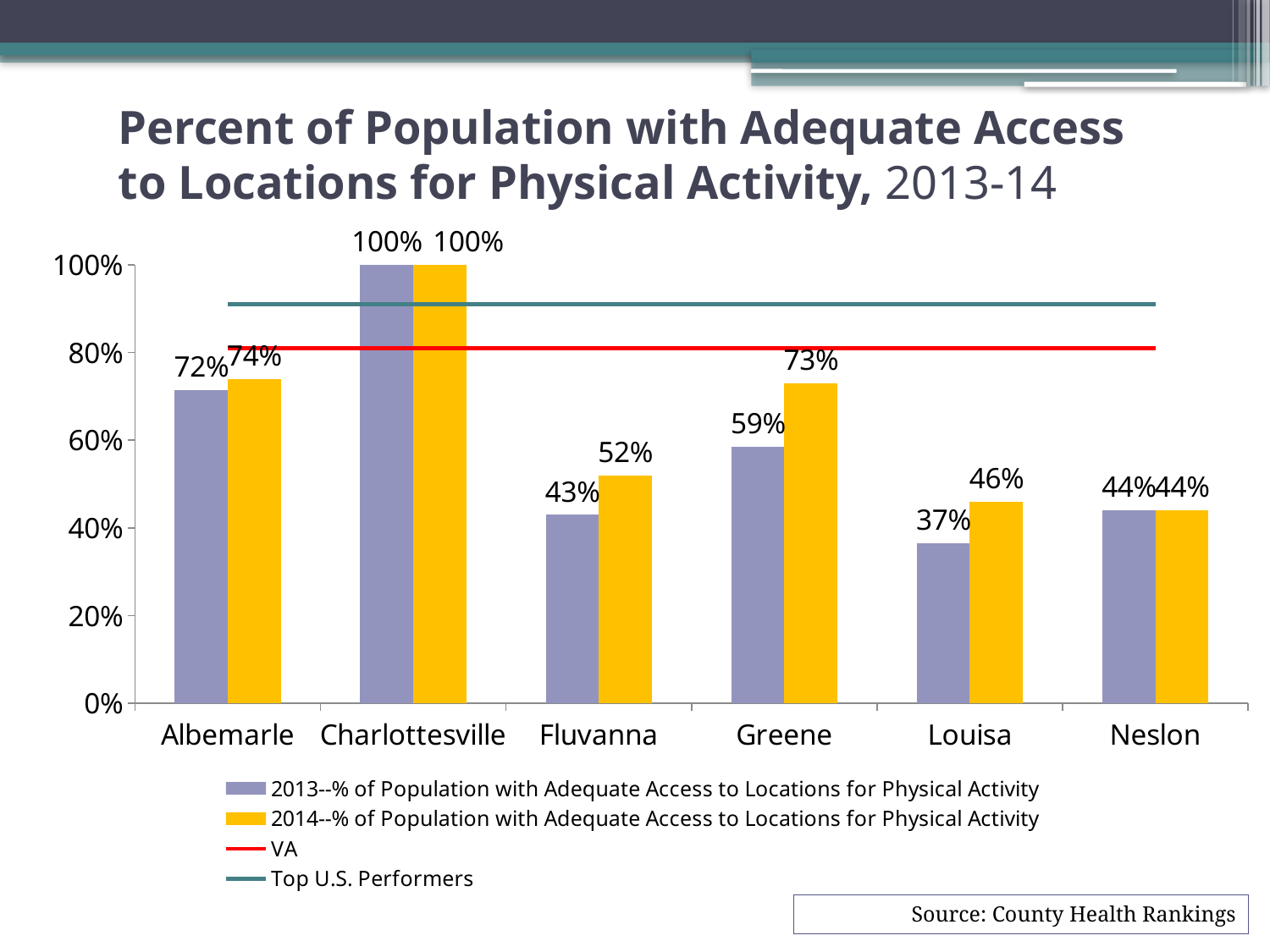
Which locality has the lowest 2013 value? Louisa Is the Top U.S. Performers line greater or less than 80%? greater How many localities are shown on the x axis? 6 Which locality has the highest 2014 value? Charlottesville What is the 2014 value for Greene? 73% What kind of chart is shown on the slide? combination bar and line chart Which is larger, the 2014 value for Albemarle or the 2014 value for Greene? Albemarle What is the difference between the 2014 values for Fluvanna and Louisa? 6% What is the difference between the 2014 and 2013 values for Greene? 14% What is the 2013 value for Fluvanna? 43% How many entries does the legend list? 4 What is the 2013 value for Louisa? 37%